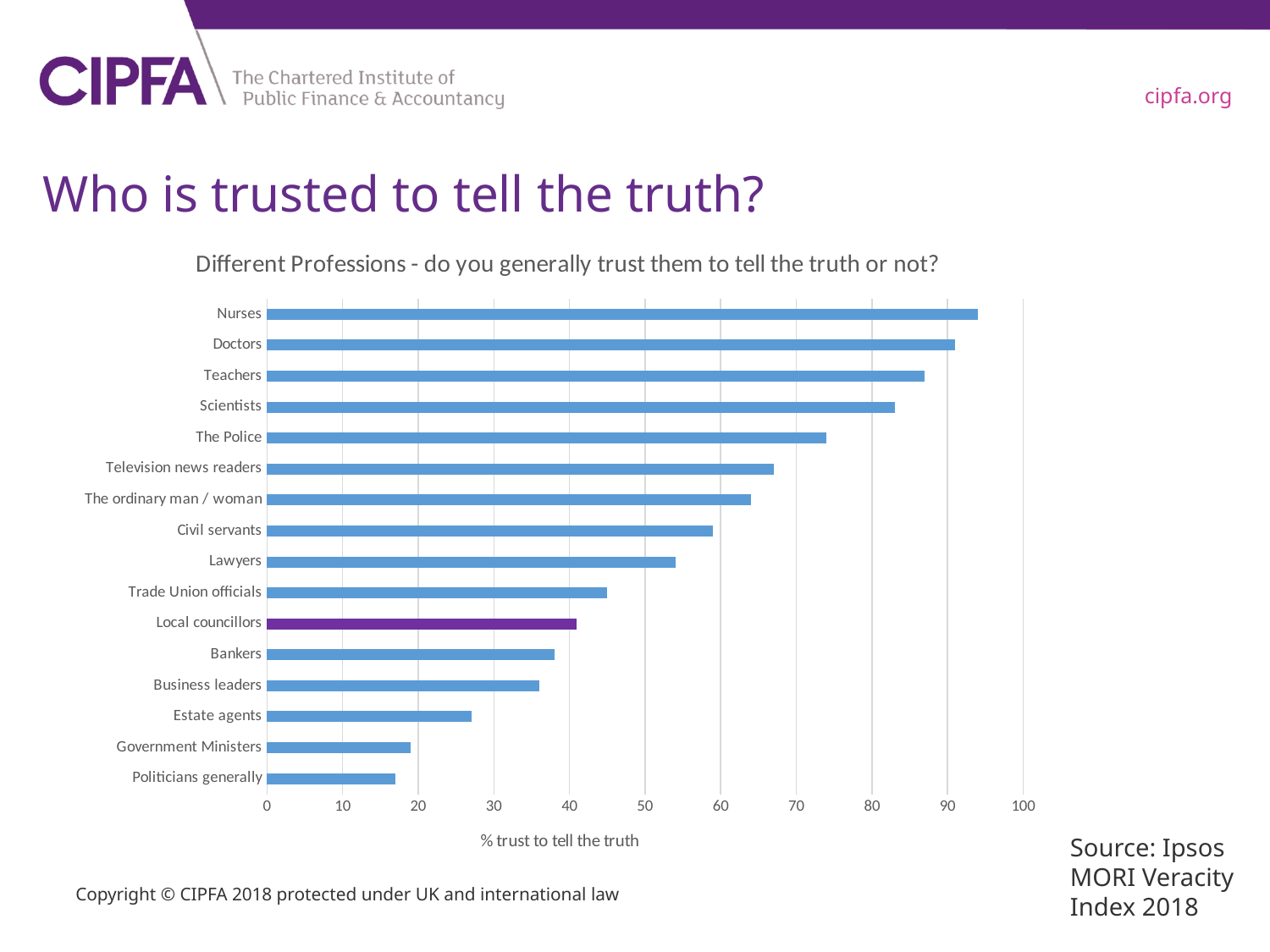
Which profession has the lowest percentage trusting them to tell the truth? Politicians generally Is the value for Nurses greater or less than 90? greater Which profession's bar is highlighted in a different colour (purple) from the others? Local councillors Is the value for Estate agents greater or less than 30? less How many professions are listed in the chart? 16 Which has a higher trust percentage, Teachers or Lawyers? Teachers Is the value for Politicians generally greater or less than 20? less Which has a lower trust percentage, Bankers or Civil servants? Bankers What type of chart is shown on the slide? bar chart Which profession has the highest percentage trusting them to tell the truth? Nurses